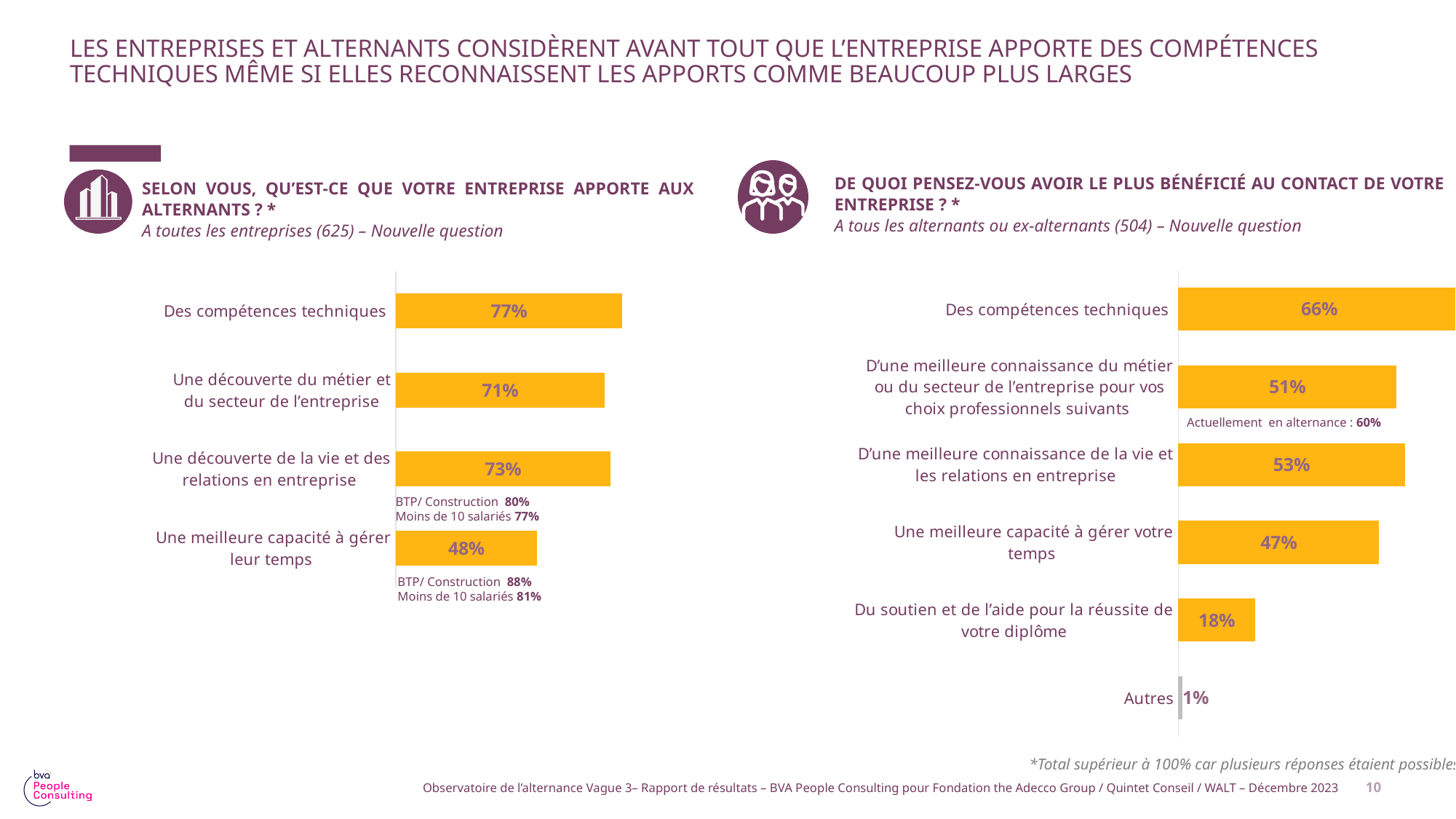
In the right chart (alternants), which category has the lowest value? Autres In the right chart (alternants), which category has the highest value? Des compétences techniques In the left chart (entreprises), which category has the lowest value? Une meilleure capacité à gérer leur temps In the left chart (entreprises), what percentage is shown for 'Des compétences techniques'? 77% In the left chart (entreprises), which is larger: 'Une découverte du métier et du secteur de l'entreprise' or 'Une découverte de la vie et des relations en entreprise'? Une découverte de la vie et des relations en entreprise What type of chart is used on the left side of the slide? Bar chart How many categories are shown in the left chart (entreprises)? 4 In the left chart (entreprises), what is the difference between 'Des compétences techniques' and 'Une meilleure capacité à gérer leur temps'? 29 percentage points In the right chart (alternants), what percentage is shown for 'Du soutien et de l'aide pour la réussite de votre diplôme'? 18% In the right chart (alternants), what is the difference between 'Des compétences techniques' and 'D'une meilleure connaissance de la vie et les relations en entreprise'? 13 percentage points How many categories are shown in the right chart (alternants)? 6 In the right chart (alternants), what value is given for 'Actuellement en alternance' under the category about better knowledge of the métier or sector? 60%